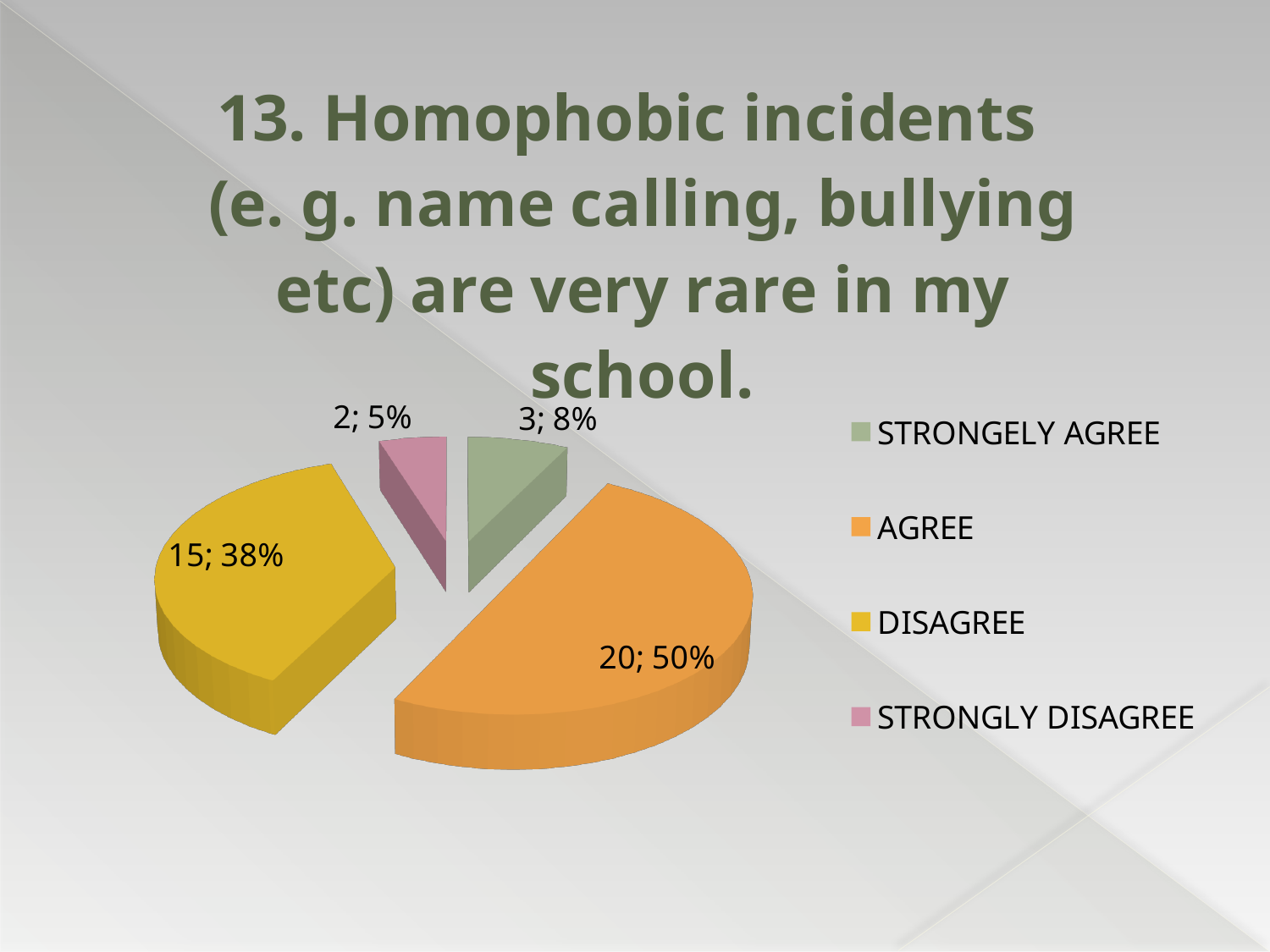
What is the total number of respondents across all slices? 40 Which category has the smallest slice of the pie? STRONGLY DISAGREE How many categories does the pie chart have? 4 What percentage of the pie does DISAGREE represent? 38% How many respondents chose STRONGLY DISAGREE? 2 Which is larger, the count for STRONGLY AGREE or the count for STRONGLY DISAGREE? STRONGLY AGREE Which colour represents DISAGREE in the legend? yellow What percentage of the pie does STRONGLY AGREE represent? 8% Which category has the largest slice of the pie? AGREE What kind of chart is shown on the slide? pie chart What is the difference in count between AGREE and DISAGREE? 5 How many respondents chose AGREE? 20